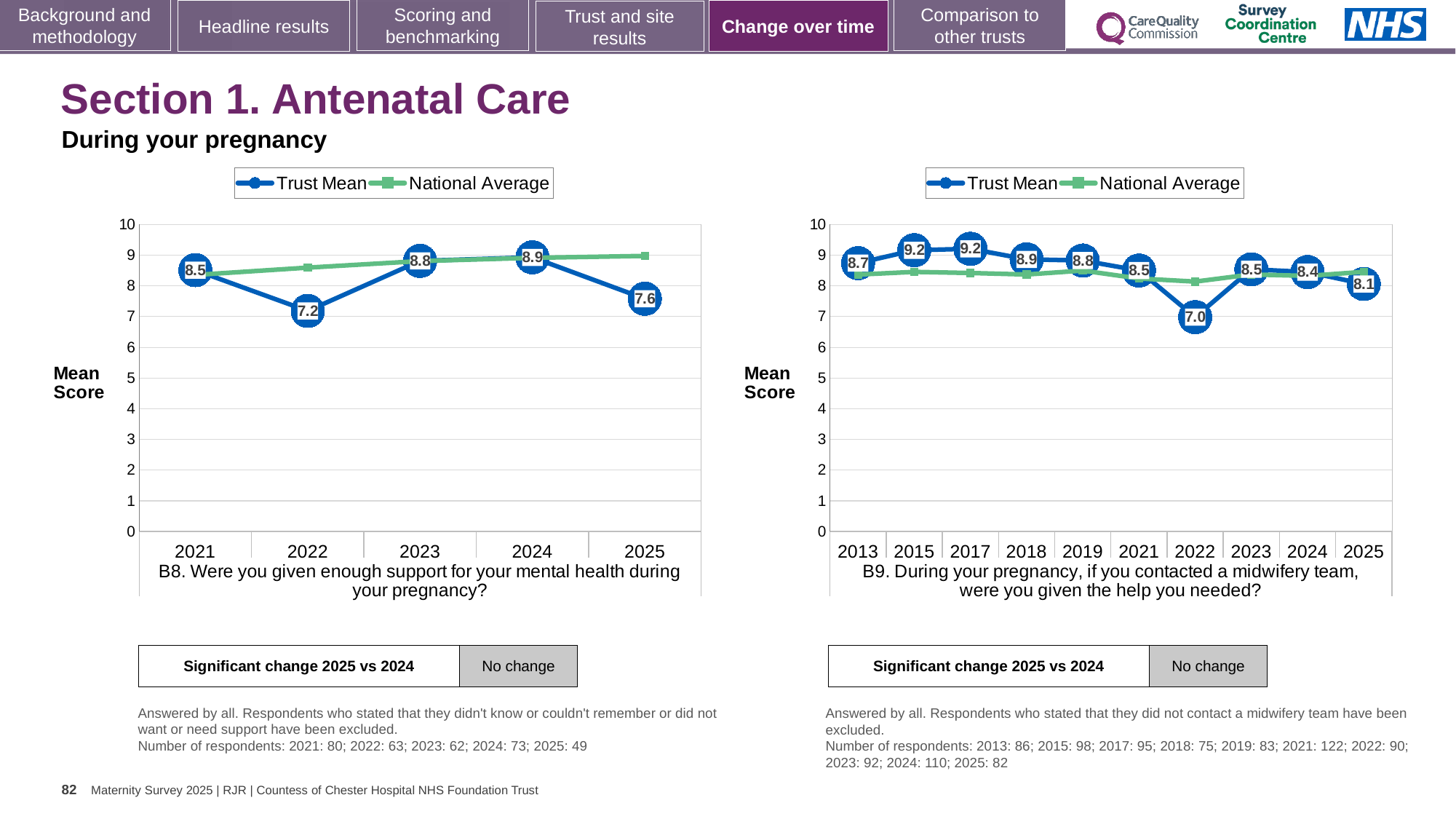
In the right chart (B9), what is the Trust Mean for 2013? 8.7 In the right chart (B9), which year has the lowest Trust Mean? 2022 In the right chart (B9), what is the Trust Mean for 2022? 7.0 In the left chart (B8), which year has the lowest Trust Mean? 2022 In the right chart (B9), is the Trust Mean for 2018 or 2024 larger? 2018 In the left chart (B8), what is the Trust Mean for 2025? 7.6 In the right chart (B9), is the National Average for 2013 greater or less than 8? greater How many series does the legend of the left chart (B8) list? 2 In the left chart (B8), what is the difference between the Trust Mean for 2024 and 2025? 1.3 In the right chart (B9), how many years are shown on the x axis? 10 In the left chart (B8), what is the Trust Mean for 2022? 7.2 In the left chart (B8), how many years are shown on the x axis? 5